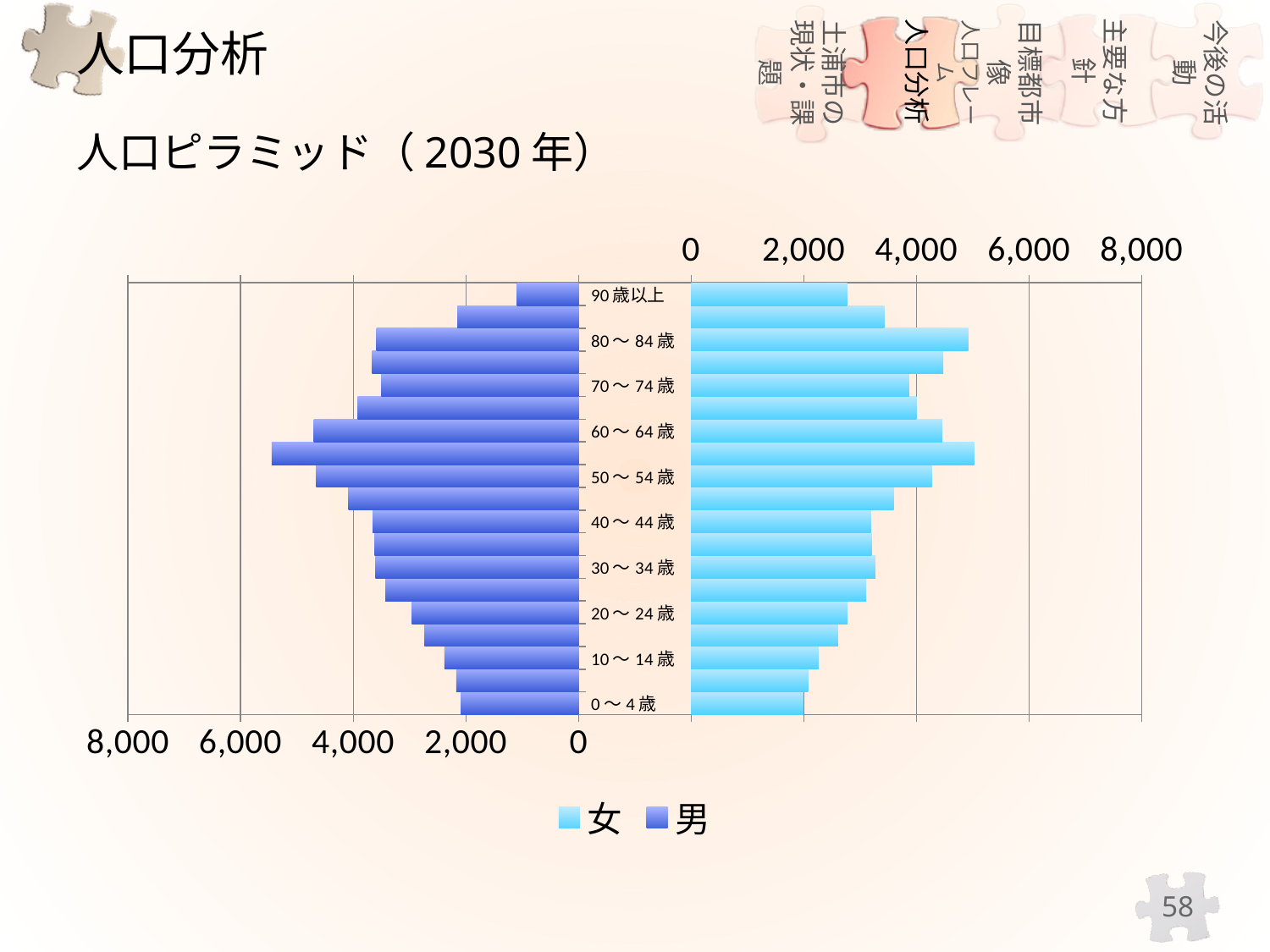
Is the value for 女 in the 90歳以上 group greater or less than 2,000? greater Is the value for 男 in the 40～44歳 group greater or less than 4,000? less What are the two series named in the legend? 女 and 男 Is the value for 女 in the 80～84歳 group greater or less than 4,000? greater How many series does the legend list? 2 Which year does the population pyramid title refer to? 2030年 What kind of chart is shown on the slide? bar chart For the 男 series, which is larger, the value for 60～64歳 or the value for 0～4歳? 60～64歳 In the 90歳以上 group, which is larger, the value for 女 or the value for 男? 女